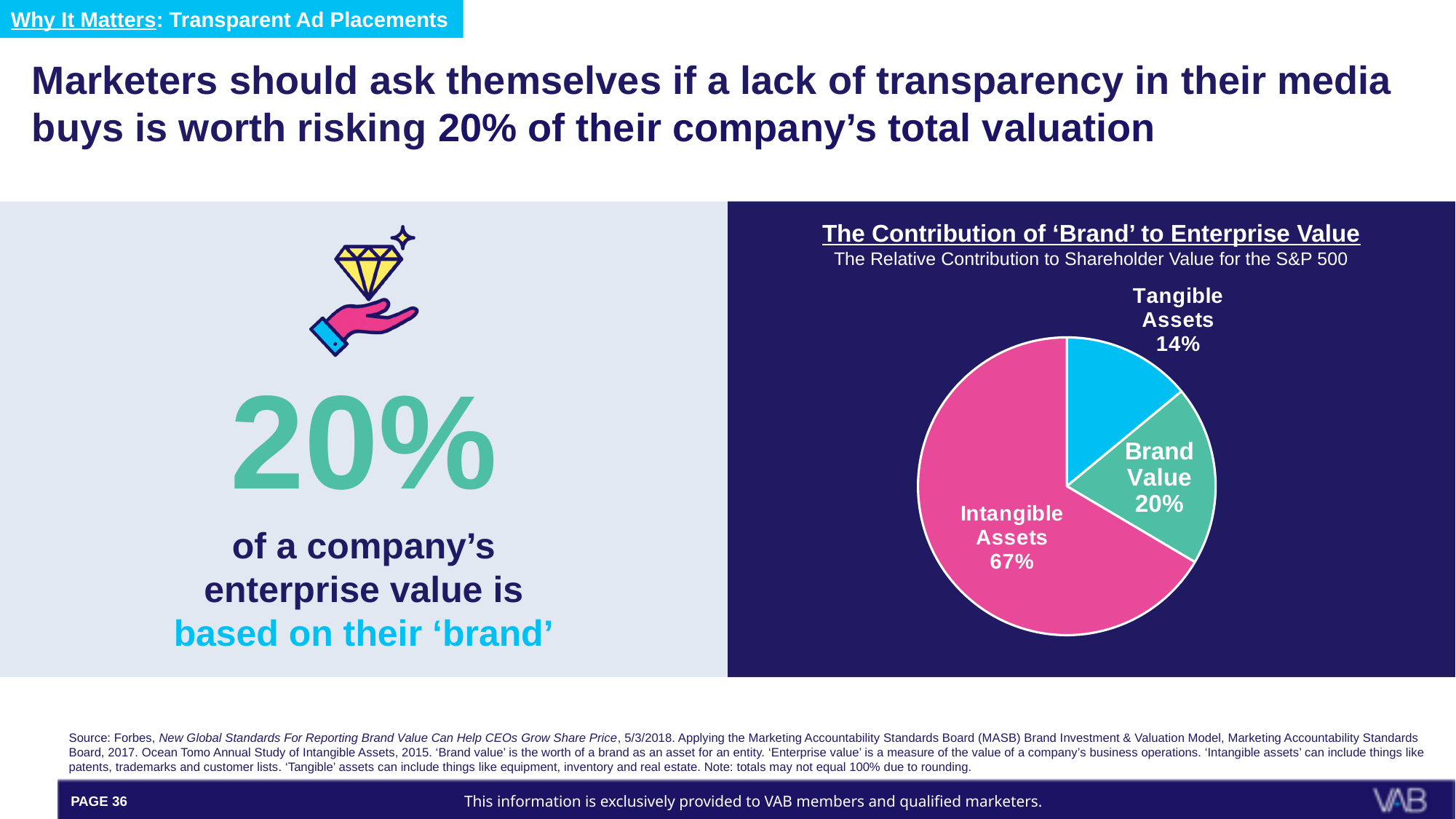
Which slice of the pie chart is the largest? Intangible Assets What share of enterprise value is attributed to Tangible Assets in the pie chart? 14% How many slices does the pie chart have? 3 What colour is the Intangible Assets slice in the pie chart? pink Which slice of the pie chart is the smallest? Tangible Assets What type of chart is shown on the slide? pie chart What is the difference in percentage points between Brand Value and Tangible Assets in the pie chart? 6 What is the title of the pie chart? The Contribution of 'Brand' to Enterprise Value What share of enterprise value is attributed to Intangible Assets in the pie chart? 67% What is the difference in percentage points between Intangible Assets and Brand Value in the pie chart? 47 What share of enterprise value is attributed to Brand Value in the pie chart? 20% Which is larger in the pie chart, Brand Value or Tangible Assets? Brand Value